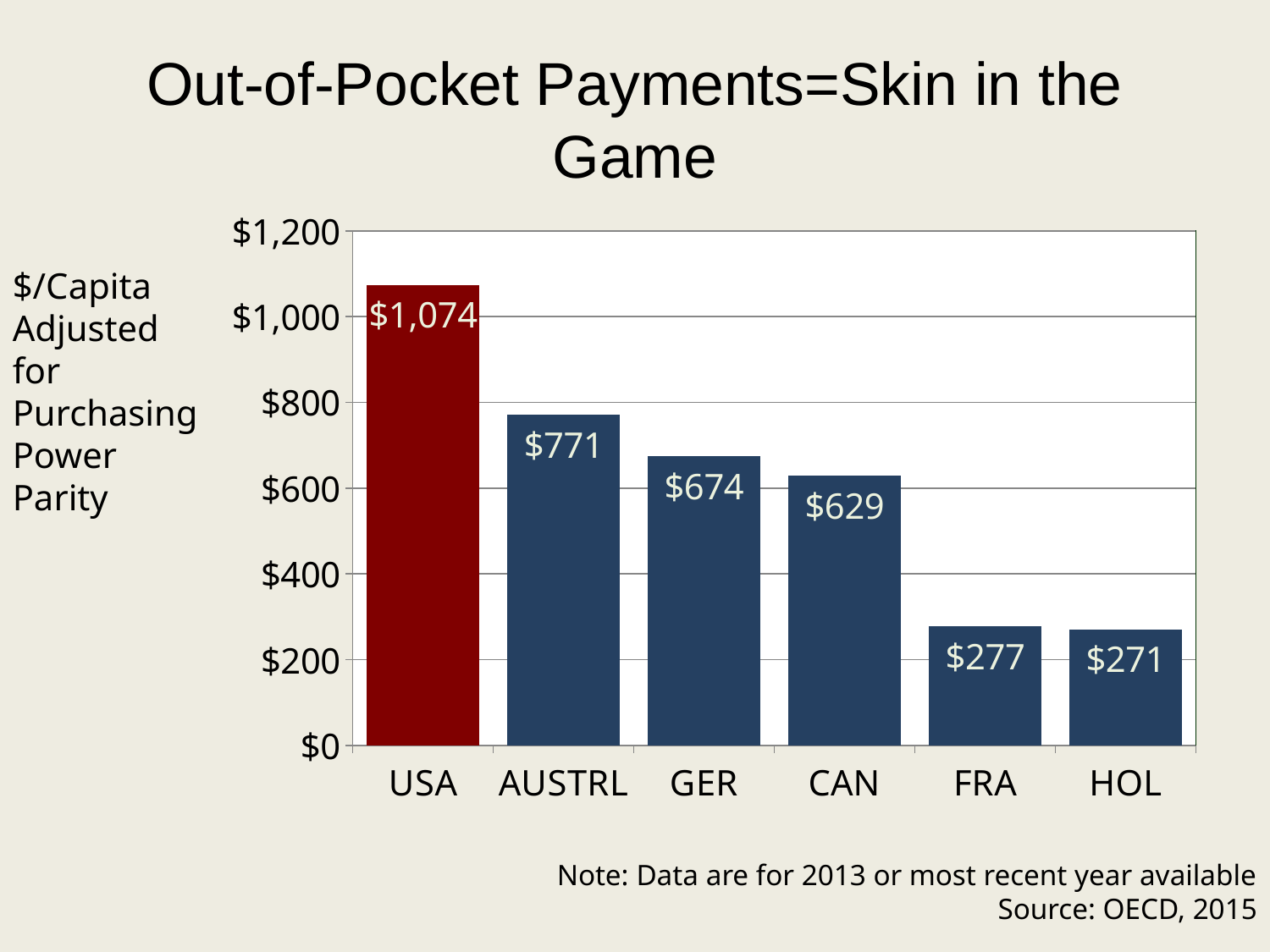
Is the value for CAN greater or less than $800? less Which country has the lowest out-of-pocket payment per capita? HOL What is the out-of-pocket payment value for USA? $1,074 How many countries are shown in the chart? 6 Which bar is coloured differently (dark red) from the others? USA What is the difference between the values for USA and AUSTRL? $303 Which is larger, the value for AUSTRL or the value for CAN? AUSTRL What is the difference between the values for GER and CAN? $45 What is the value shown for FRA? $277 What kind of chart is shown on the slide? bar chart Which country has the highest out-of-pocket payment per capita? USA What is the value shown for GER? $674